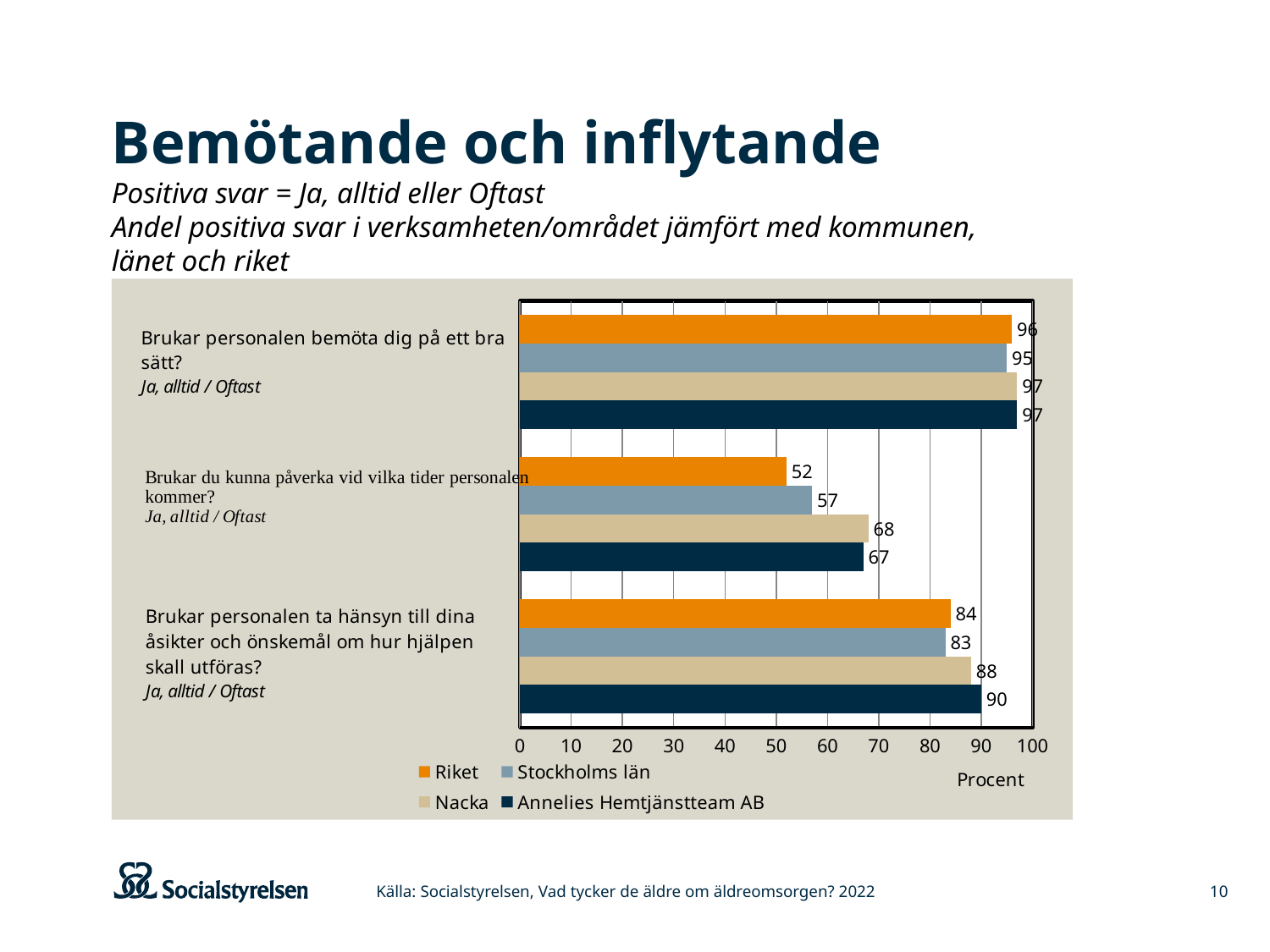
Which series has the lowest value on the question "Brukar personalen ta hänsyn till dina åsikter och önskemål om hur hjälpen skall utföras?"? Stockholms län What unit label is shown on the x axis of the chart? Procent What is the value for Annelies Hemtjänstteam AB on the question "Brukar personalen ta hänsyn till dina åsikter och önskemål om hur hjälpen skall utföras?"? 90 What is the value for Stockholms län on the question "Brukar personalen bemöta dig på ett bra sätt?"? 95 Which series has the highest value on the question "Brukar du kunna påverka vid vilka tider personalen kommer?"? Nacka On the question "Brukar personalen ta hänsyn till dina åsikter och önskemål om hur hjälpen skall utföras?", which is larger: the value for Annelies Hemtjänstteam AB or the value for Riket? Annelies Hemtjänstteam AB What is the difference between the Nacka and Riket values on the question "Brukar du kunna påverka vid vilka tider personalen kommer?"? 16 What is the value for Riket on the question "Brukar du kunna påverka vid vilka tider personalen kommer?"? 52 Is the value for Stockholms län on the question "Brukar du kunna påverka vid vilka tider personalen kommer?" greater or less than 60? less What kind of chart is shown on the slide? Bar chart How many question categories are plotted on the chart? 3 How many series does the legend list? 4